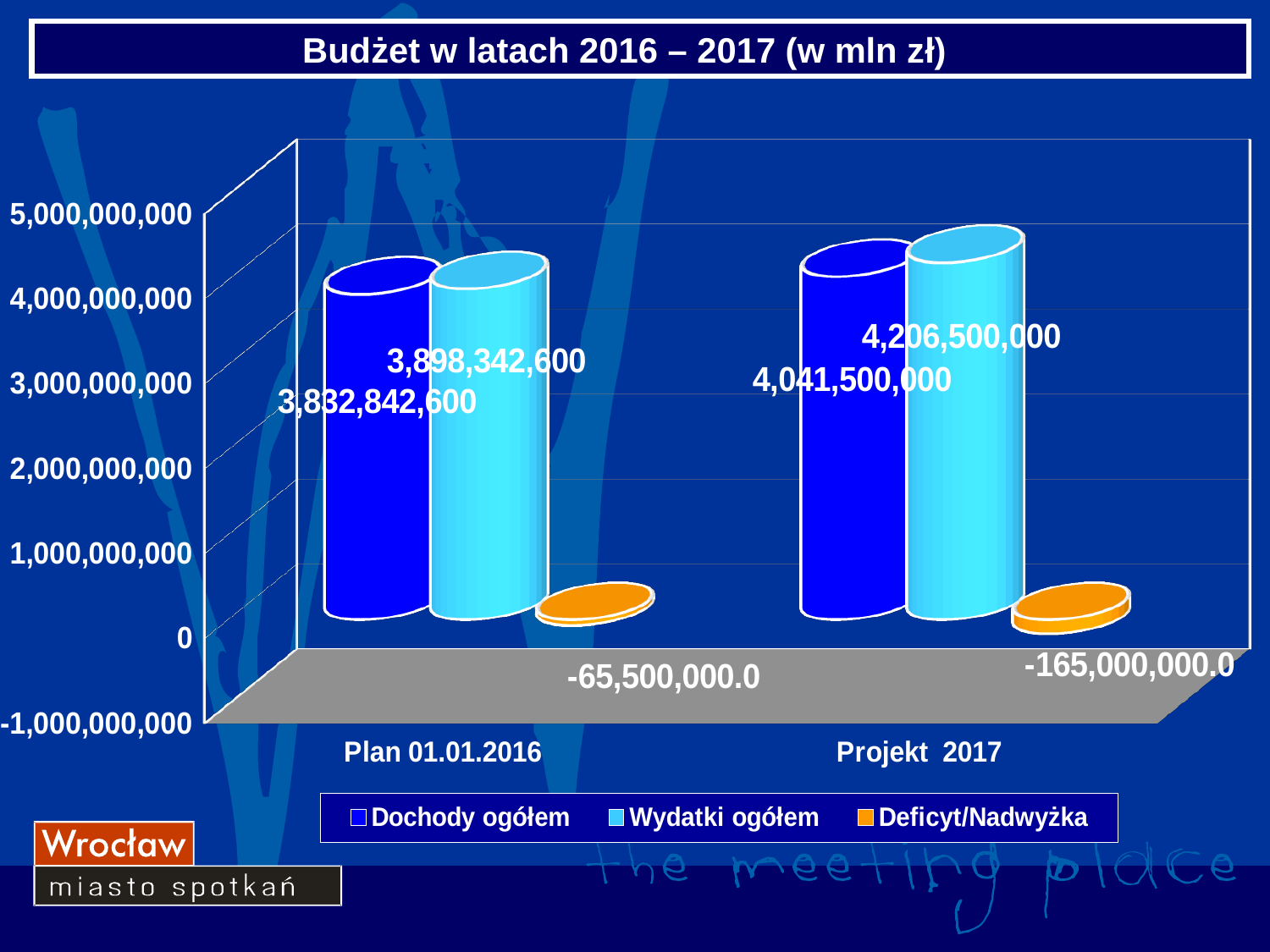
How many series does the legend list? 3 Is Wydatki ogółem for Plan 01.01.2016 larger or smaller than Dochody ogółem for Plan 01.01.2016? larger By how much does Dochody ogółem for Projekt 2017 exceed Dochody ogółem for Plan 01.01.2016? 208,657,400 What is the title of the chart? Budżet w latach 2016 – 2017 (w mln zł) What is the Deficyt/Nadwyżka value for Projekt 2017? -165,000,000.0 Which category has the higher Wydatki ogółem value? Projekt 2017 Which category has the lower Dochody ogółem value? Plan 01.01.2016 What kind of chart is shown on the slide? bar chart What is the value of Dochody ogółem for Plan 01.01.2016? 3,832,842,600 What is the Deficyt/Nadwyżka value for Plan 01.01.2016? -65,500,000.0 What is the value of Wydatki ogółem for Projekt 2017? 4,206,500,000 What is the difference between Wydatki ogółem and Dochody ogółem for Projekt 2017? 165,000,000